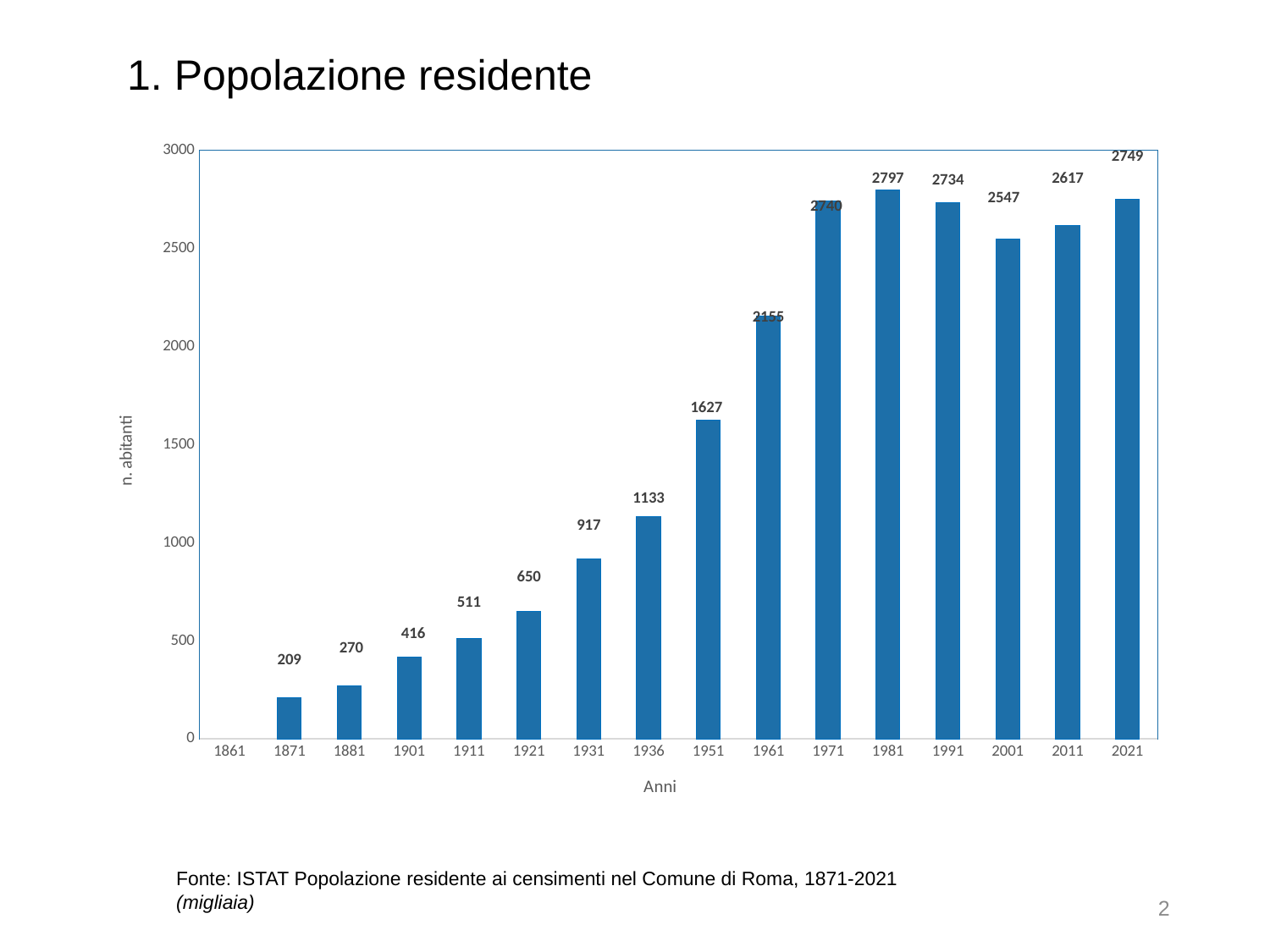
Is the value for 1961 greater or less than 2000? greater How many bars are plotted in the chart? 15 Do the values rise or fall from 1871 to 1981? rise Which is larger, the value for 2001 or the value for 2011? 2011 What is the value for 1871? 209 What is the value for 1951? 1627 What is the label of the y axis? n. abitanti What type of chart is shown on the slide? bar chart What is the value for 2021? 2749 Which year with a bar has the lowest value? 1871 Which year has the highest value? 1981 What is the difference between the values for 2021 and 2011? 132